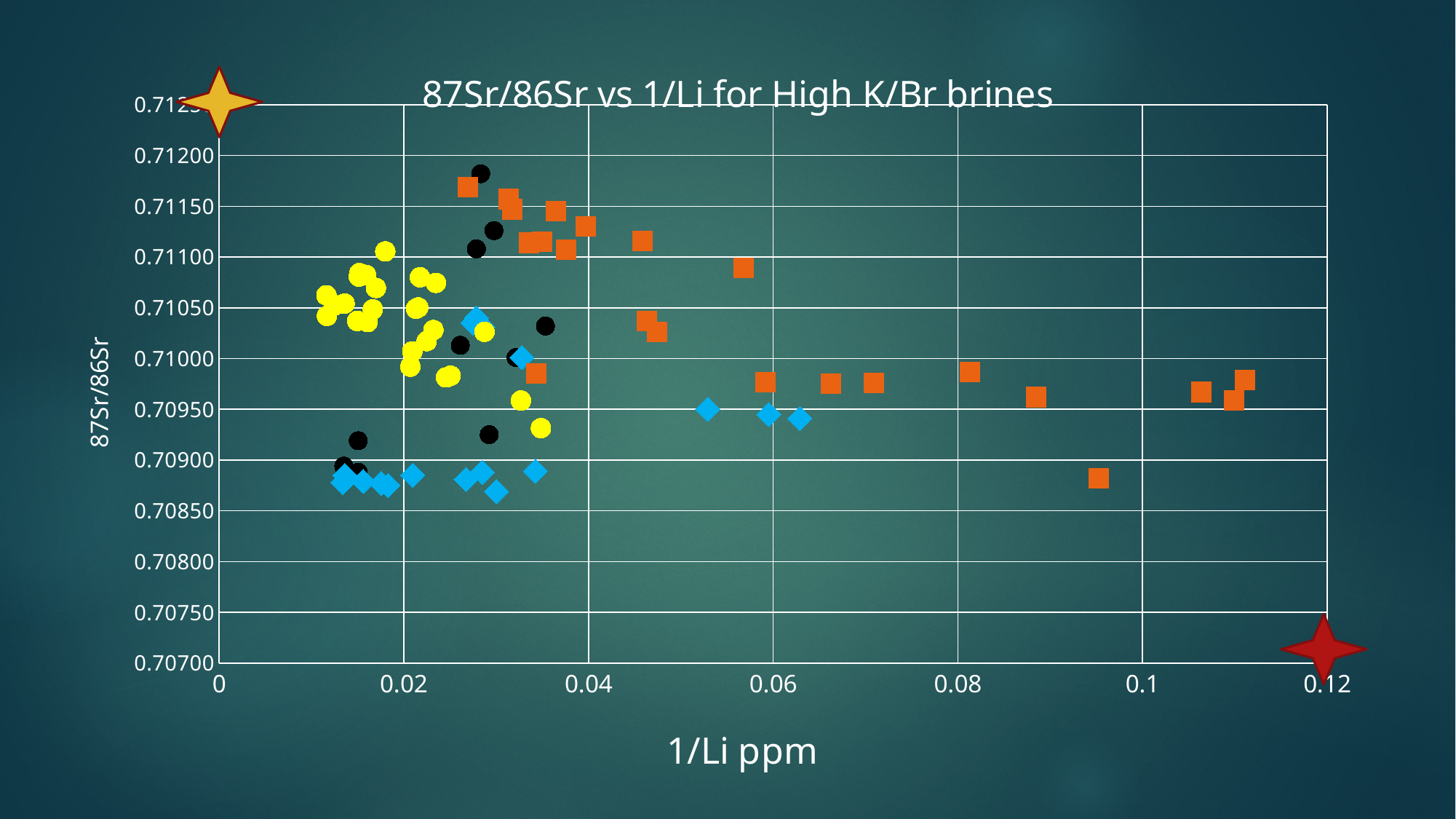
How many distinct marker types (colour/shape groups) are plotted on the chart? 4 What kind of chart is shown on the slide? scatter chart What is the label on the x axis of the chart? 1/Li ppm Do the y values of the orange square markers generally rise or fall as x increases? fall Is the y value of the highest point on the chart greater or less than 0.71150? greater Is the lowest y value among the blue diamond markers greater or less than 0.70900? less Which marker group extends to the highest x values on the chart? orange squares Is the largest x value among the yellow circle markers greater or less than 0.04? less What is the title of the chart? 87Sr/86Sr vs 1/Li for High K/Br brines